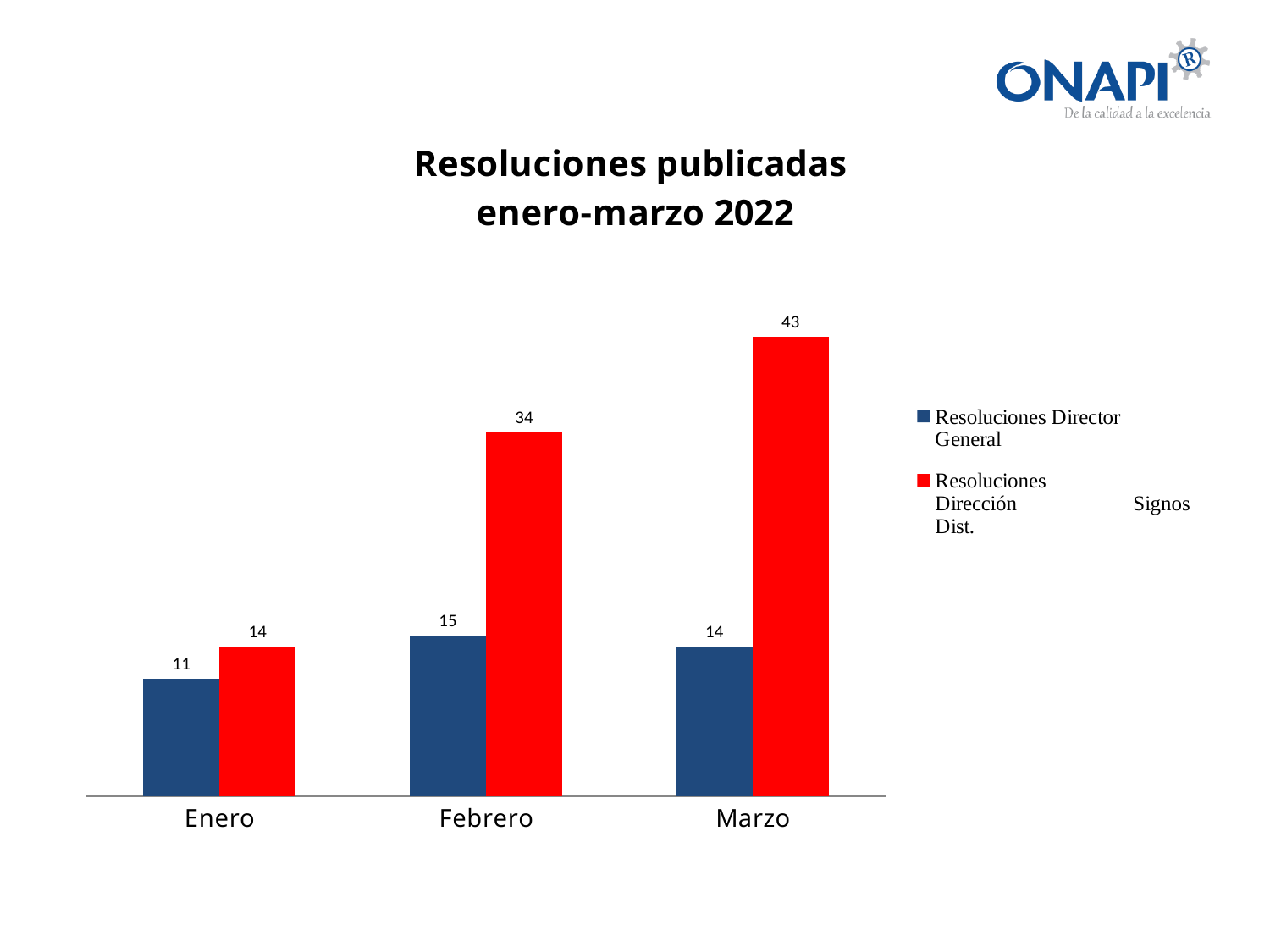
What is the value for Resoluciones Dirección Signos Dist. in Marzo? 43 Do the values for Resoluciones Dirección Signos Dist. rise or fall from Enero to Marzo? Rise In which month is the value for Resoluciones Dirección Signos Dist. highest? Marzo What kind of chart is shown on the slide? Bar chart Which is larger in Febrero: Resoluciones Director General or Resoluciones Dirección Signos Dist.? Resoluciones Dirección Signos Dist. What is the difference between Resoluciones Dirección Signos Dist. and Resoluciones Director General in Marzo? 29 What is the difference between the Resoluciones Dirección Signos Dist. values for Marzo and Febrero? 9 How many months are shown on the x axis? 3 What is the value for Resoluciones Dirección Signos Dist. in Febrero? 34 In which month is the value for Resoluciones Director General lowest? Enero How many series does the legend list? 2 What is the value for Resoluciones Director General in Enero? 11